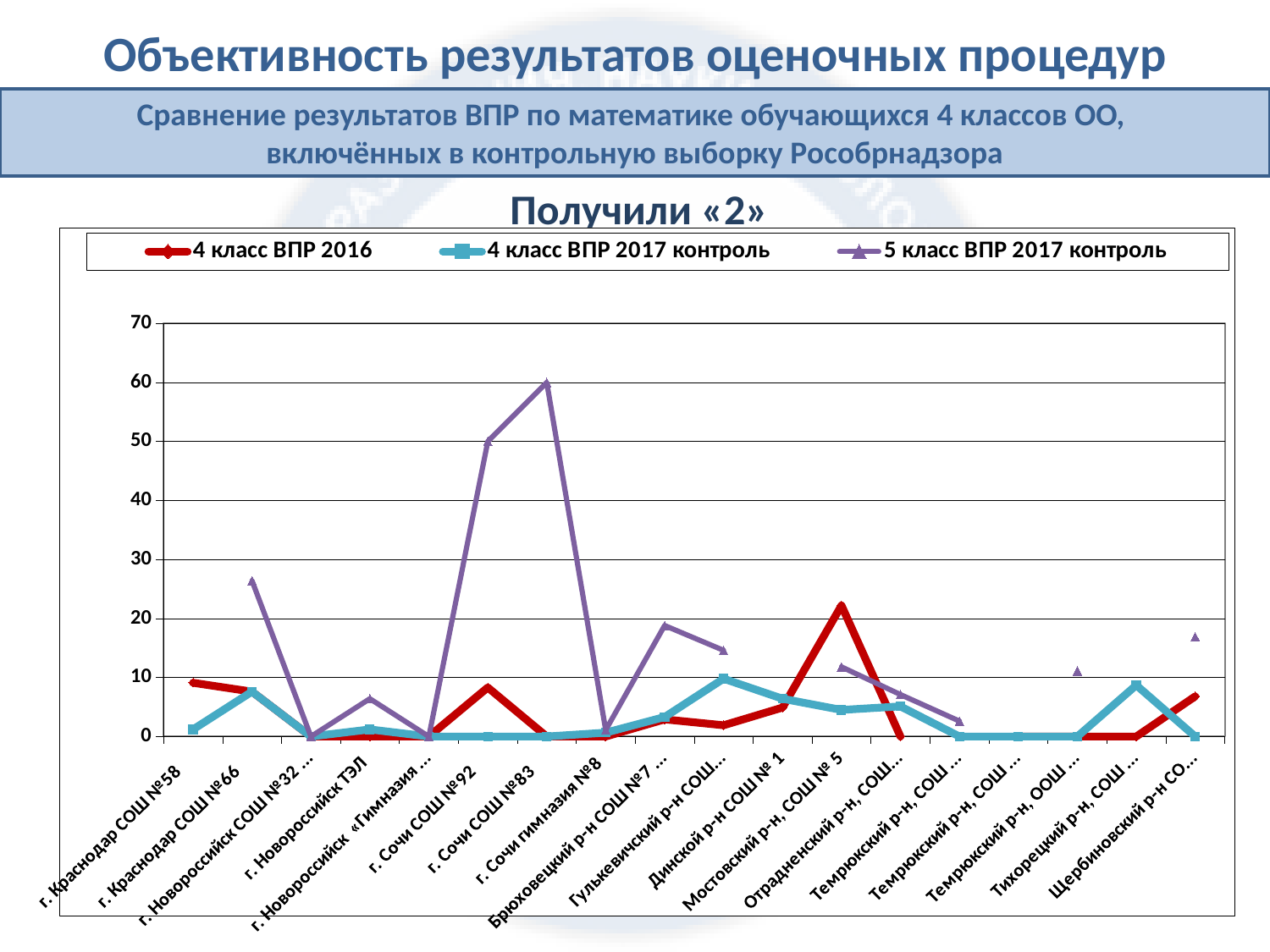
How many school categories are plotted along the x axis? 18 What is the value of '5 класс ВПР 2017 контроль' for г. Сочи СОШ №83? 60 Is the value of '4 класс ВПР 2016' for Мостовский р-н, СОШ № 5 greater or less than 20? greater What is the title shown directly above the chart? Получили «2» For which school does the series '5 класс ВПР 2017 контроль' reach its highest value? г. Сочи СОШ №83 Is the value of '5 класс ВПР 2017 контроль' for г. Краснодар СОШ №66 greater or less than 20? greater What kind of chart is shown on the slide? line chart How many series does the legend list? 3 For г. Сочи СОШ №92, which series has the larger value: '4 класс ВПР 2016' or '5 класс ВПР 2017 контроль'? 5 класс ВПР 2017 контроль For Мостовский р-н, СОШ № 5, which series has the larger value: '4 класс ВПР 2016' or '4 класс ВПР 2017 контроль'? 4 класс ВПР 2016 For which school does the series '4 класс ВПР 2016' reach its highest value? Мостовский р-н, СОШ № 5 Is the value of '5 класс ВПР 2017 контроль' for г. Сочи СОШ №92 greater or less than 40? greater